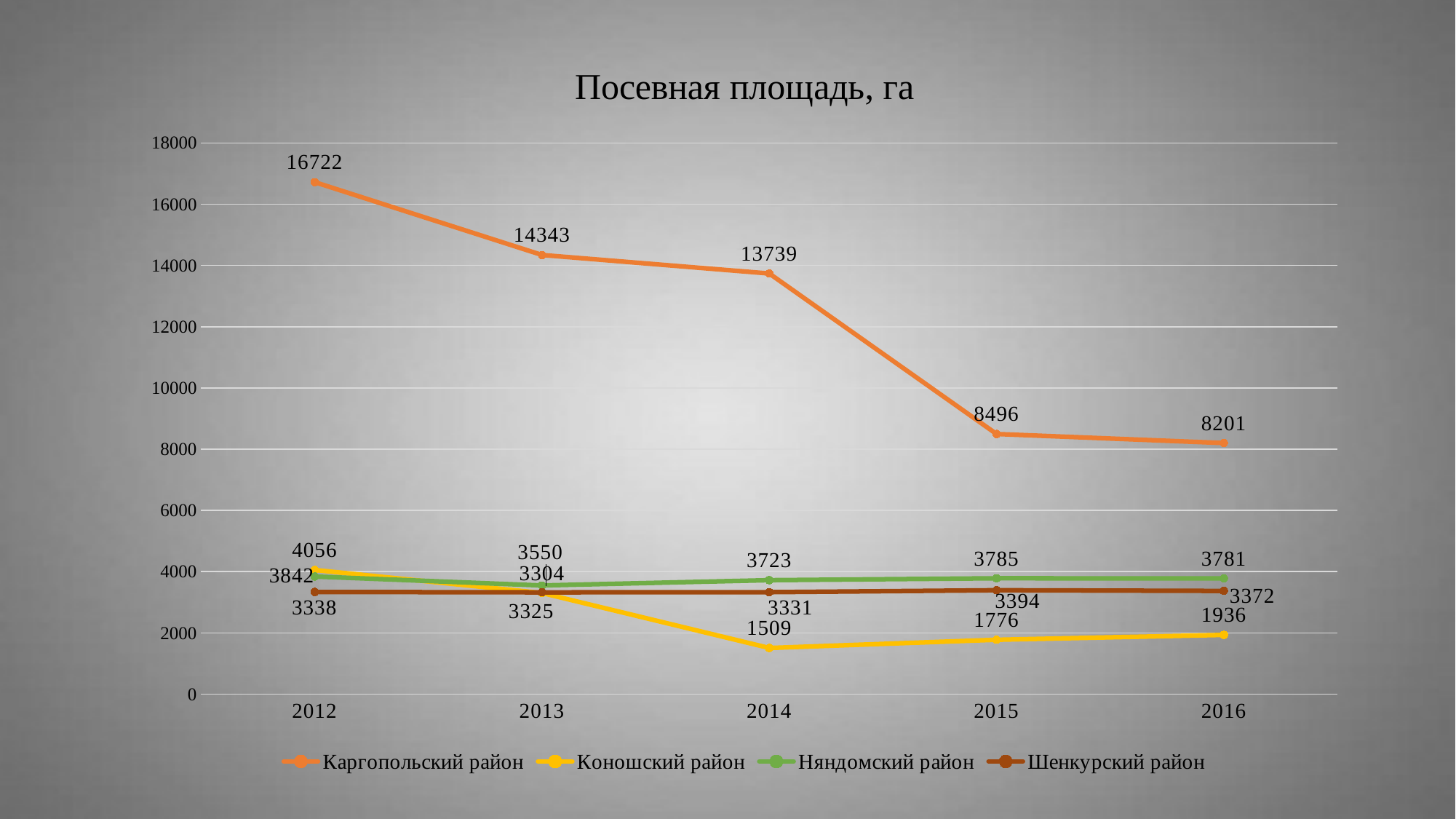
Is the value for Каргопольский район in 2015 greater or less than 10000? less What is the value for Коношский район in 2014? 1509 In which year is the value for Коношский район the lowest? 2014 What is the value for Няндомский район in 2016? 3781 What is the value for Шенкурский район in 2015? 3394 In 2016, which is larger: Няндомский район or Шенкурский район? Няндомский район How many series does the legend list? 4 What is the value for Каргопольский район in 2012? 16722 How many years are shown on the x axis? 5 What kind of chart is shown on the slide? line chart What is the difference between the values for Каргопольский район in 2012 and 2016? 8521 In which year is the value for Каргопольский район the highest? 2012